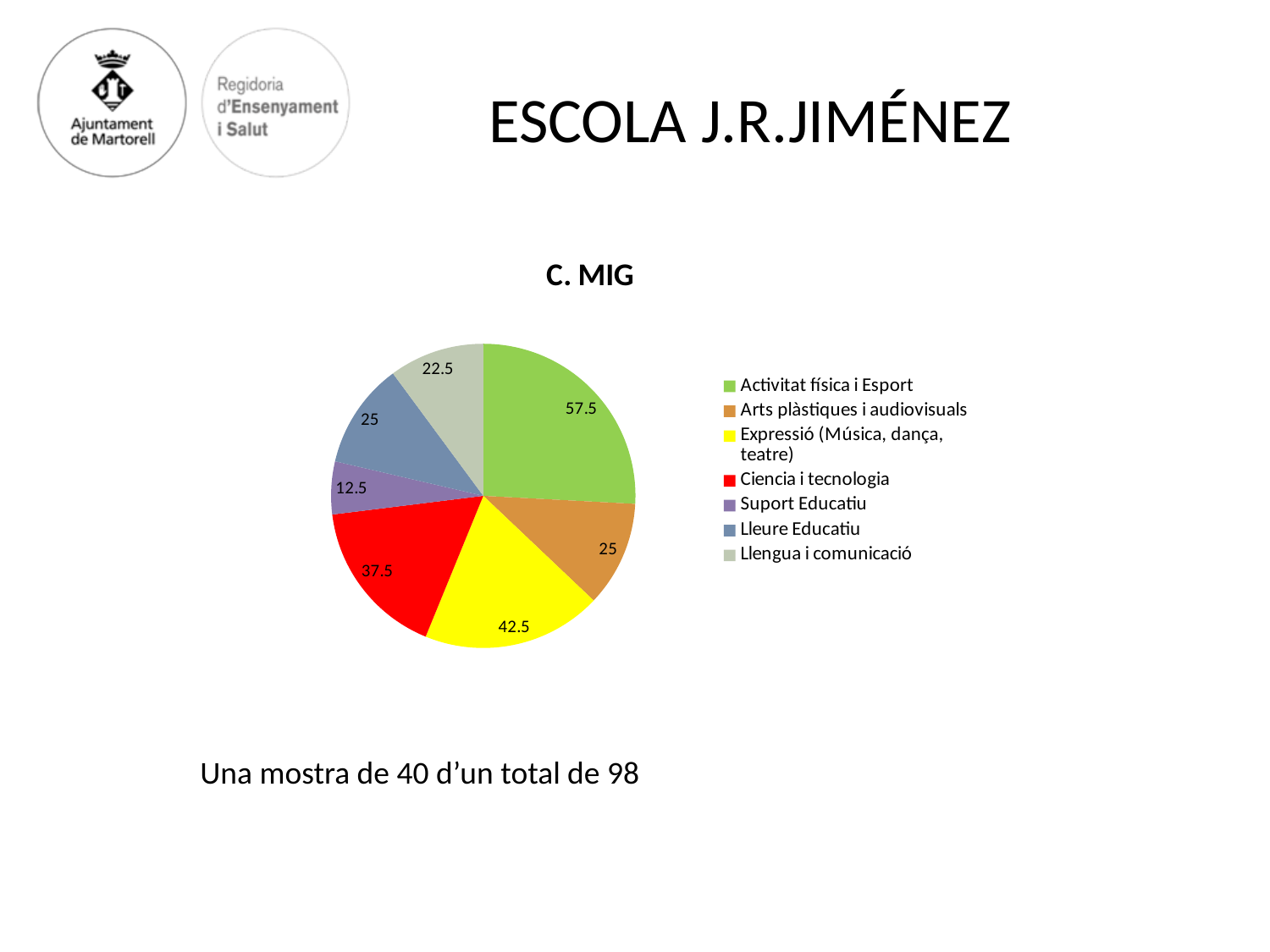
What is the value for Activitat física i Esport in the C. MIG pie chart? 57.5 What is the value for Suport Educatiu in the C. MIG pie chart? 12.5 What is the difference between the values for Ciencia i tecnologia and Suport Educatiu in the C. MIG pie chart? 25 Which is larger in the C. MIG pie chart: Expressió (Música, dança, teatre) or Ciencia i tecnologia? Expressió (Música, dança, teatre) Which category has the largest slice in the C. MIG pie chart? Activitat física i Esport What is the value for Ciencia i tecnologia in the C. MIG pie chart? 37.5 What is the title of the chart on the slide? C. MIG What kind of chart is shown on the slide? Pie chart Which category has the smallest slice in the C. MIG pie chart? Suport Educatiu How many categories are shown in the C. MIG pie chart? 7 What is the value for Llengua i comunicació in the C. MIG pie chart? 22.5 What is the difference between the values for Activitat física i Esport and Expressió (Música, dança, teatre) in the C. MIG pie chart? 15